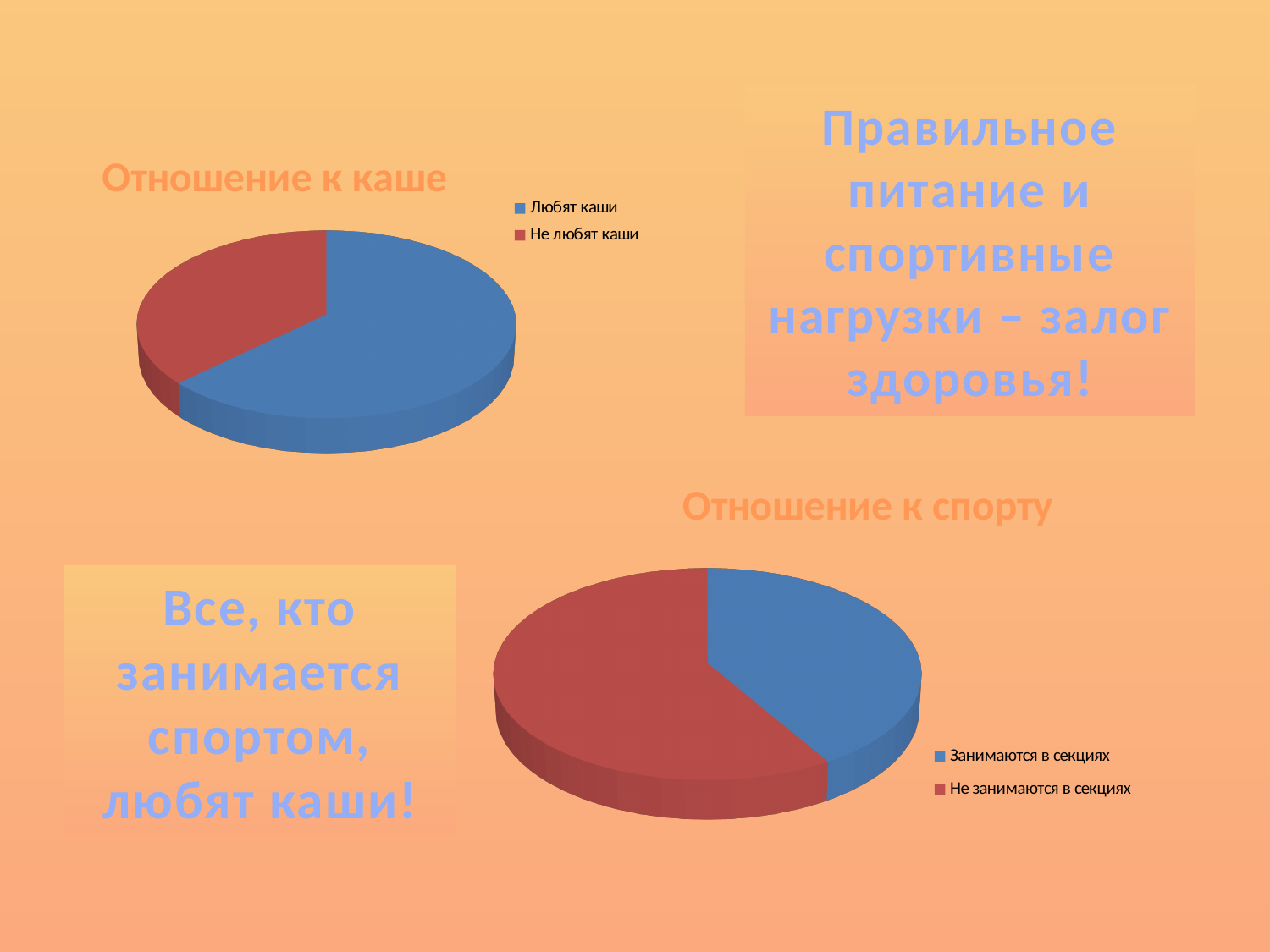
In the "Отношение к каше" chart, how many entries does the legend list? 2 What kind of chart is the "Отношение к каше" chart? Pie chart In the "Отношение к каше" chart, which slice is the largest? Любят каши What is the title of the pie chart in the lower right of the slide? Отношение к спорту In the "Отношение к спорту" chart, which is larger: "Занимаются в секциях" or "Не занимаются в секциях"? Не занимаются в секциях In the "Отношение к спорту" chart, which slice is the largest? Не занимаются в секциях In the "Отношение к спорту" chart, how many entries does the legend list? 2 What kind of chart is the "Отношение к спорту" chart? Pie chart In the "Отношение к каше" chart, what colour is the "Не любят каши" slice? Red In the "Отношение к каше" chart, which slice is the smallest? Не любят каши In the "Отношение к спорту" chart, how many slices does the pie have? 2 In the "Отношение к каше" chart, how many slices does the pie have? 2